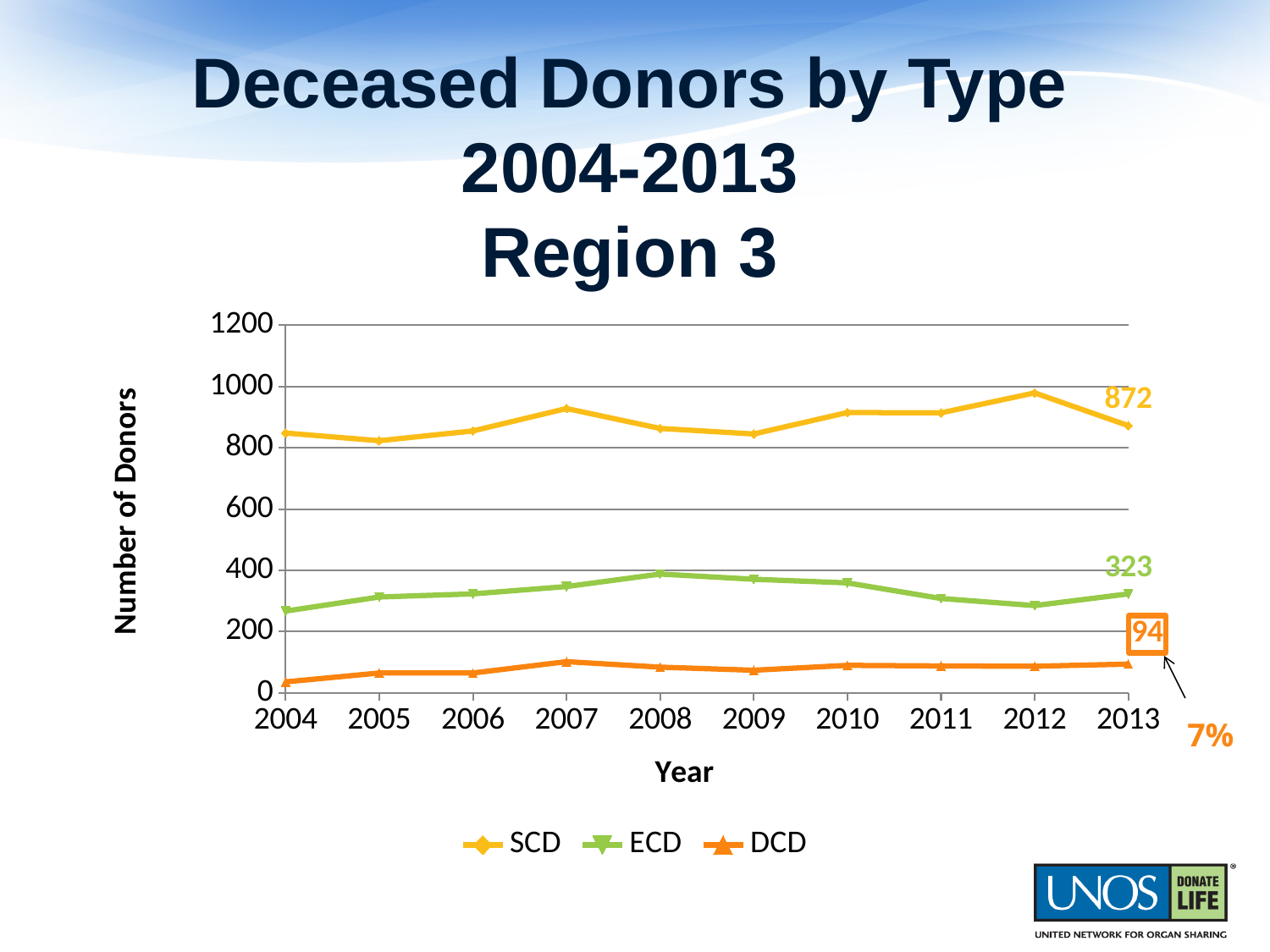
How many years are shown on the x axis? 10 How many series does the legend list? 3 What kind of chart is shown on the slide? Line chart Is the SCD value for 2012 greater or less than 800? greater Which series has the lowest value in 2013? DCD What is the DCD value for 2013? 94 What is the difference between the SCD and ECD values in 2013? 549 Which series has the highest value in 2013? SCD What is the SCD value for 2013? 872 Is the DCD value for 2007 greater or less than 200? less Is the ECD value for 2008 greater or less than 600? less What is the ECD value for 2013? 323